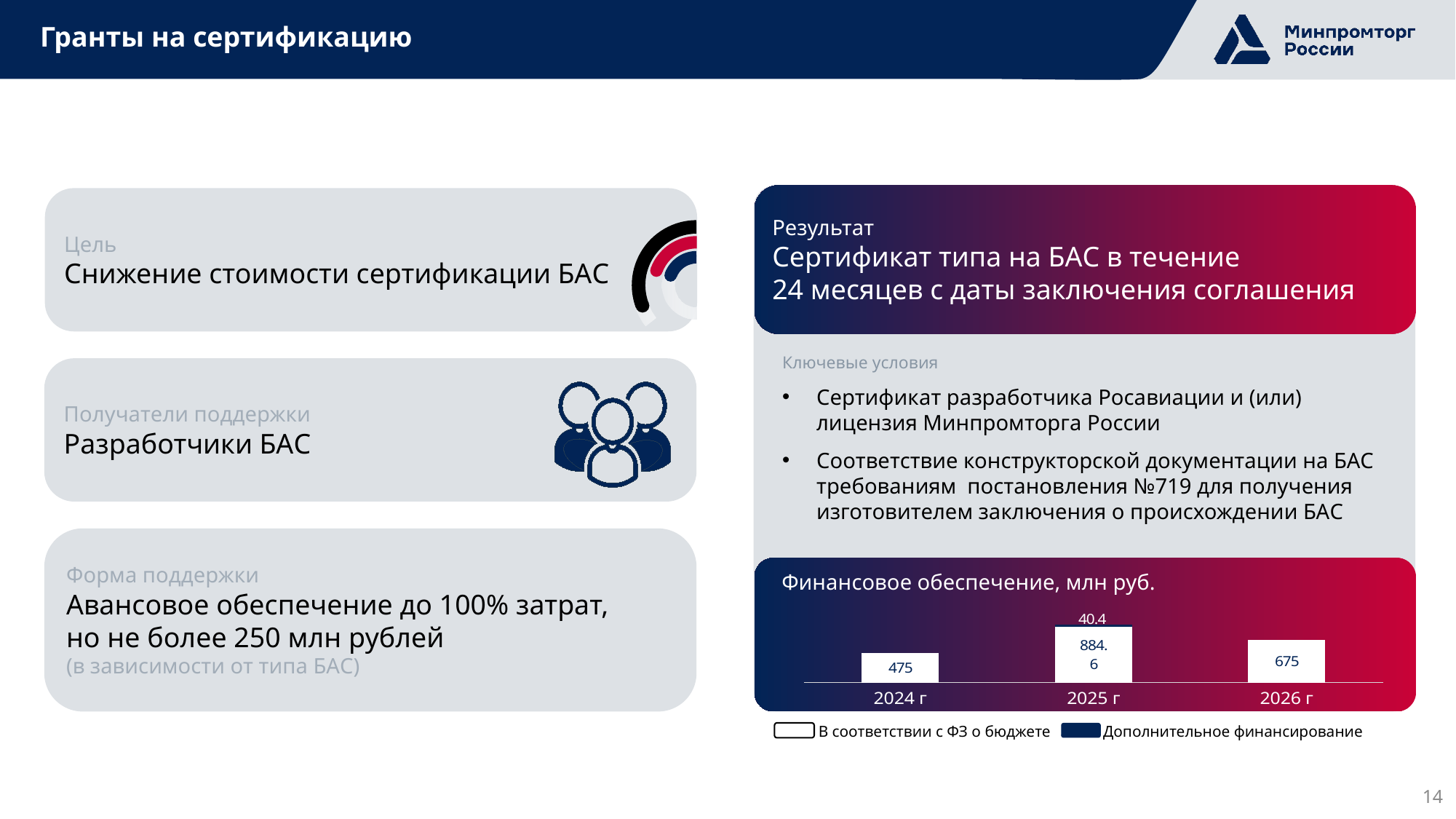
What is the value for 2026 г in the chart? 675 How many series does the chart legend list? 2 What is the value of the 'В соответствии с ФЗ о бюджете' series for 2025 г? 884.6 What is the value for 2024 г in the 'Финансовое обеспечение, млн руб.' chart? 475 Which year has the highest total in the 'Финансовое обеспечение' chart? 2025 г What is the difference between the values for 2026 г and 2024 г? 200 What is the total of the stacked bar for 2025 г? 925 What type of chart is used for 'Финансовое обеспечение, млн руб.'? Stacked bar chart Which year has the lowest value in the 'Финансовое обеспечение' chart? 2024 г Which is larger: the value for 2026 г or the value for 2024 г? 2026 г How many years (categories) are shown on the x axis of the chart? 3 What is the value of the 'Дополнительное финансирование' series for 2025 г? 40.4